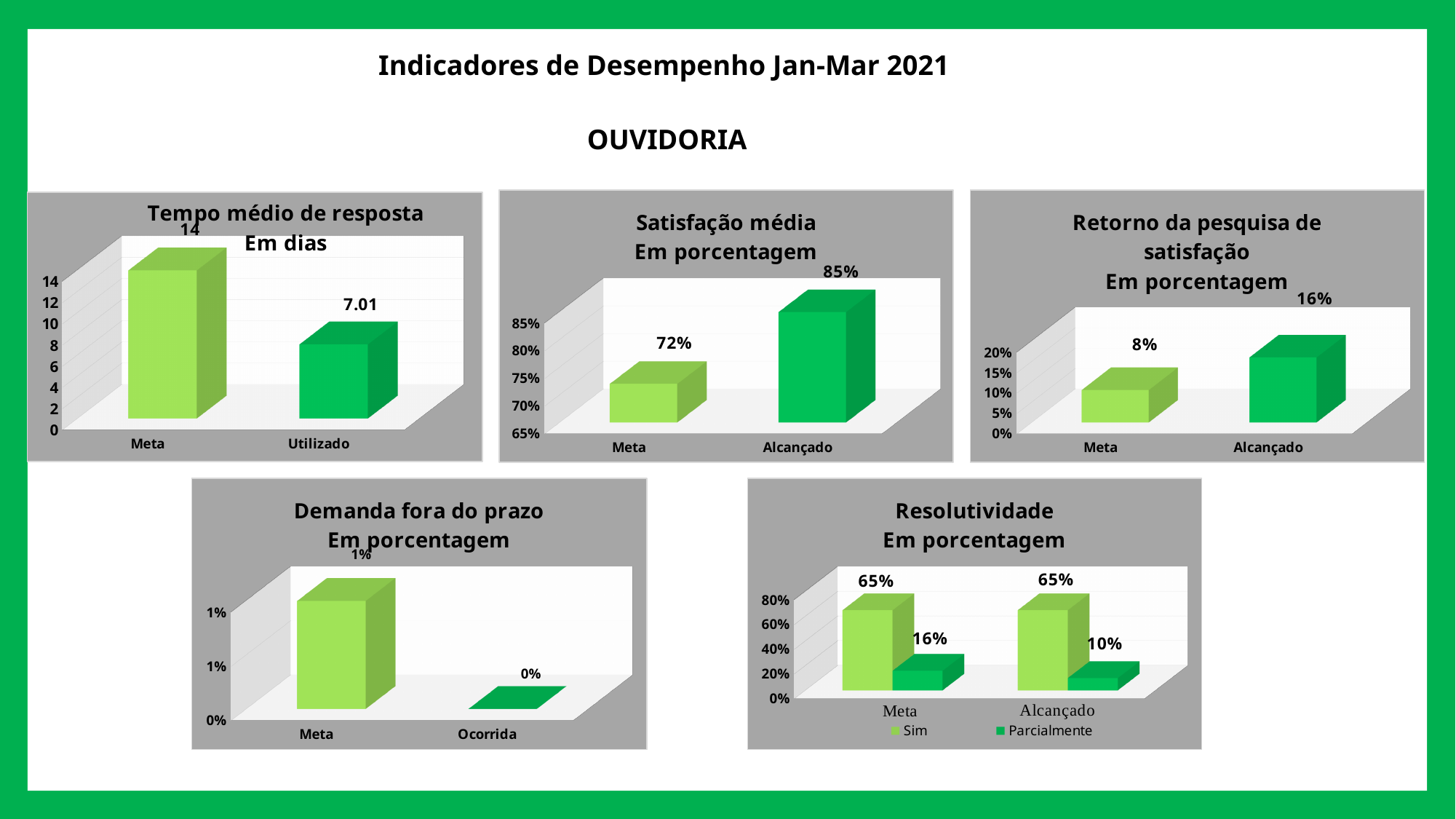
In the 'Resolutividade' chart, what is the Parcialmente value for Alcançado? 10% In the 'Retorno da pesquisa de satisfação' chart, what is the difference between Alcançado and Meta? 8% In the 'Satisfação média' chart, what is the value for Alcançado? 85% In the 'Retorno da pesquisa de satisfação' chart, what is the value for Meta? 8% What kind of chart is the 'Satisfação média' chart? Bar chart In the 'Tempo médio de resposta' chart, what is the difference between Meta and Utilizado? 6.99 In the 'Tempo médio de resposta' chart, what is the value for Meta? 14 In the 'Resolutividade' chart, how many series does the legend list? 2 In the 'Satisfação média' chart, what is the difference between Alcançado and Meta? 13% In the 'Satisfação média' chart, which category is higher, Meta or Alcançado? Alcançado In the 'Demanda fora do prazo' chart, what is the value for Ocorrida? 0% In the 'Tempo médio de resposta' chart, what is the value for Utilizado? 7.01